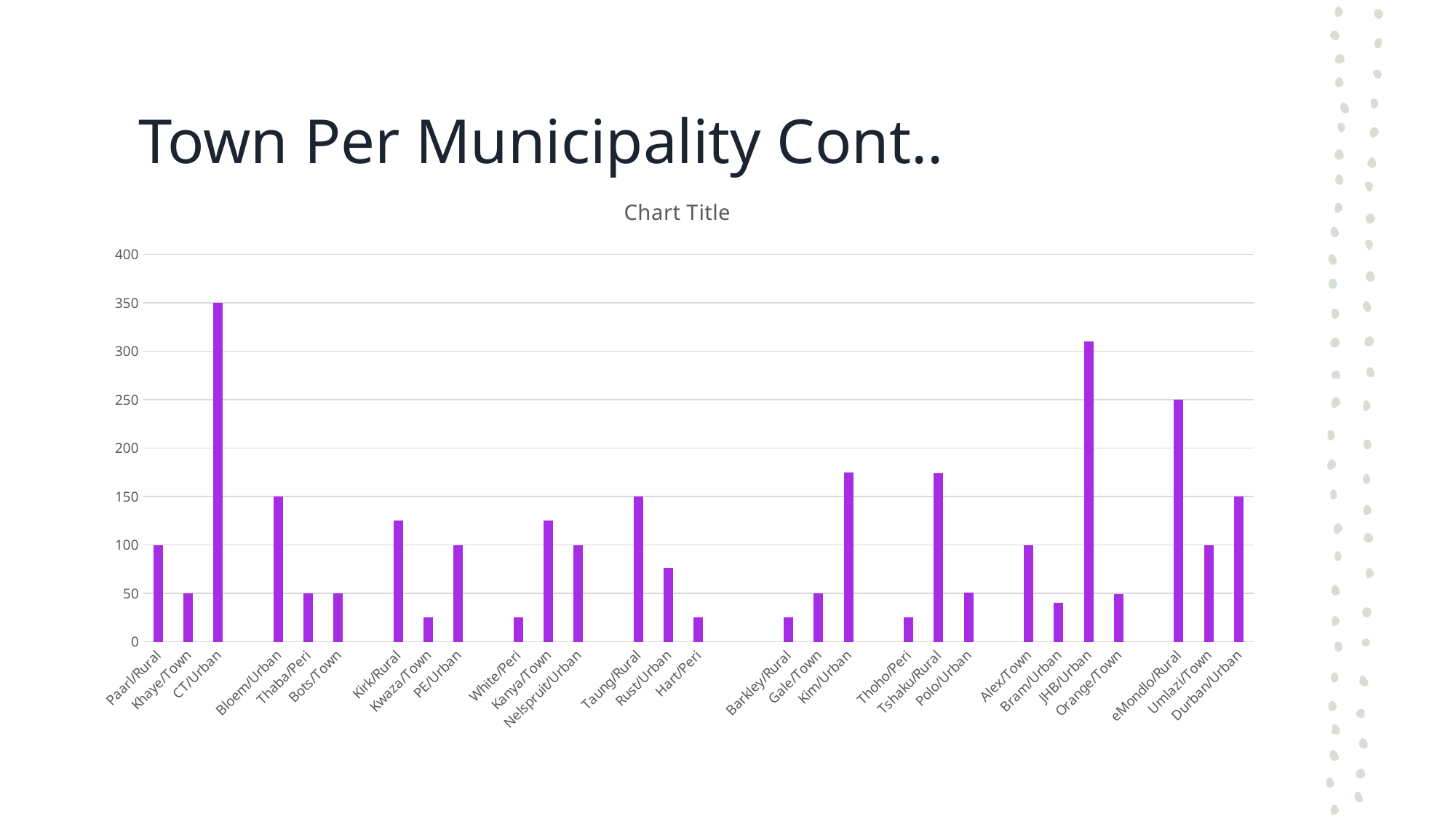
What is the value for eMondlo/Rural? 250 Is the value for Kwaza/Town greater or less than 50? less How many categories are shown on the x axis? 28 What is the value for CT/Urban? 350 What is the value for Paarl/Rural? 100 Which is larger, the value for JHB/Urban or the value for eMondlo/Rural? JHB/Urban What type of chart is shown on the slide? bar chart What is the value for Bloem/Urban? 150 What is the difference between the values for CT/Urban and eMondlo/Rural? 100 Is the value for Kirk/Rural greater or less than 100? greater Which category has the highest value? CT/Urban What is the title shown above the chart? Chart Title